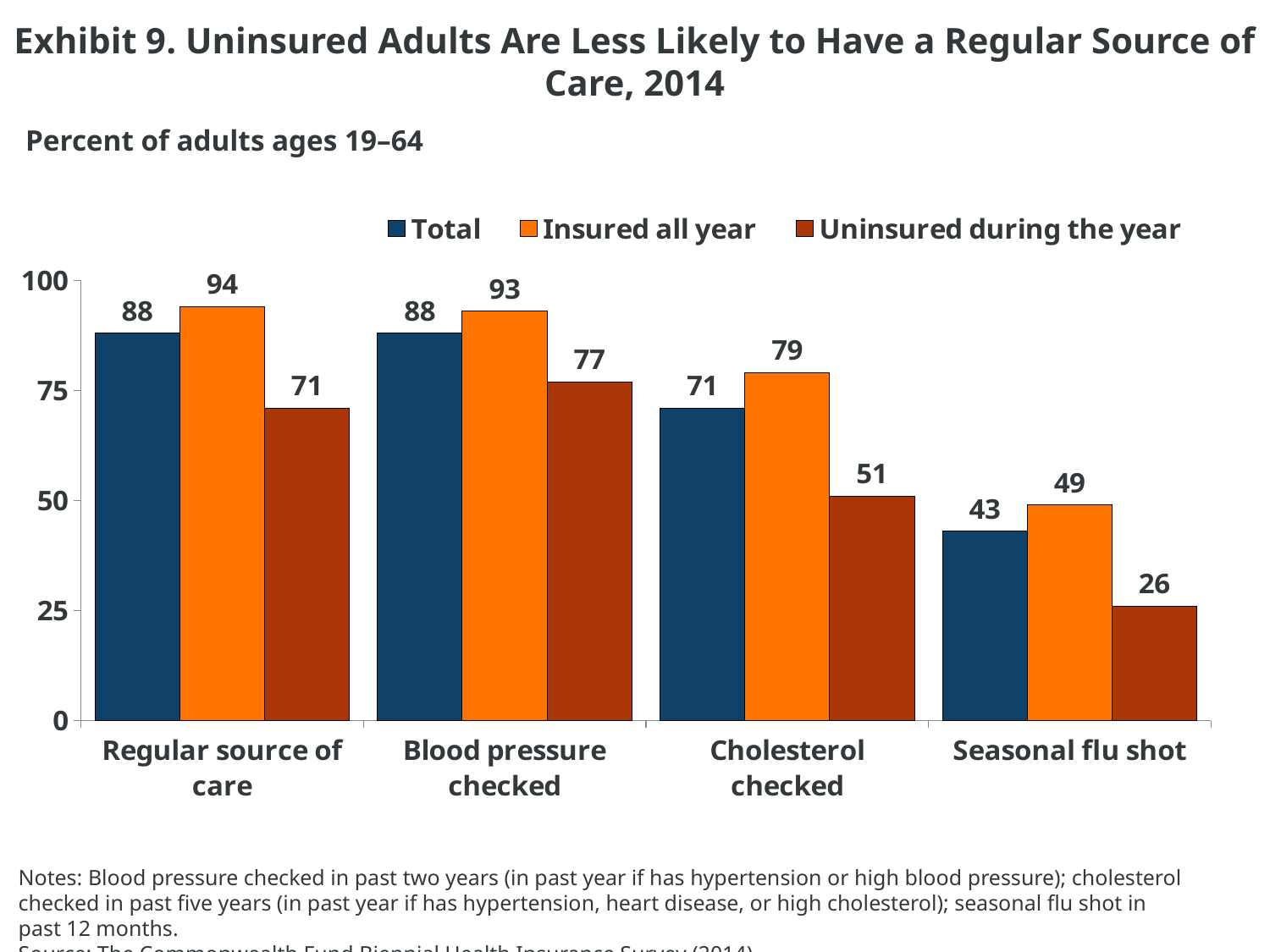
What is the value for Insured all year for Regular source of care? 94 Which series is shown in orange in the legend? Insured all year Which category has the lowest value for Uninsured during the year? Seasonal flu shot Which is larger for Seasonal flu shot: the Total value or the Uninsured during the year value? Total What kind of chart is shown on the slide? Bar chart How many series does the legend list? 3 Which category has the highest value for Insured all year? Regular source of care What is the difference between Insured all year and Uninsured during the year for Cholesterol checked? 28 What is the Total value for Cholesterol checked? 71 What is the value for Uninsured during the year for Seasonal flu shot? 26 How many categories are shown on the x axis? 4 What is the difference between Insured all year and Uninsured during the year for Blood pressure checked? 16